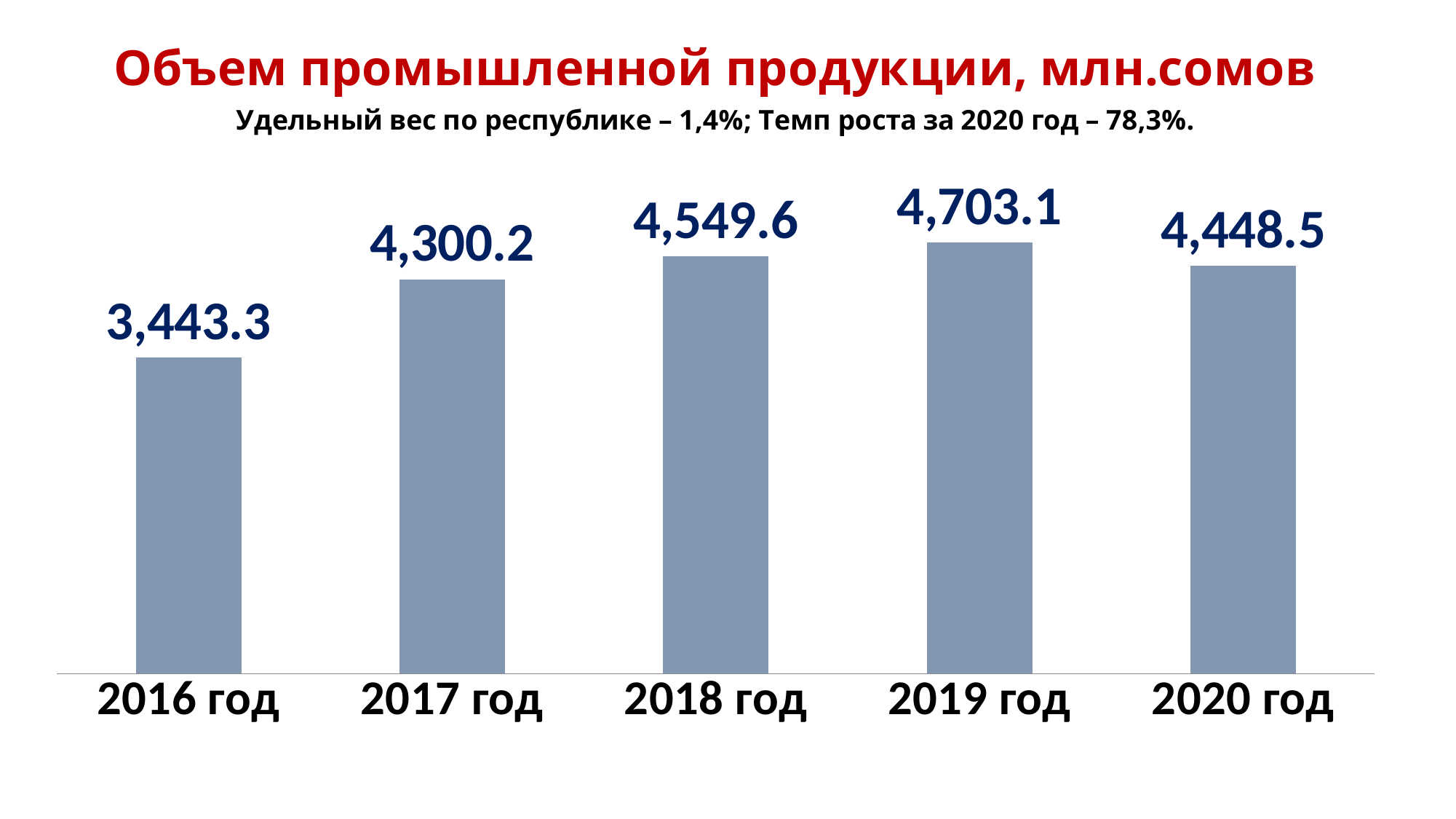
Do the values rise or fall from 2016 год to 2019 год? Rise By how much did the value fall from 2019 год to 2020 год? 254.6 What is the title of the chart? Объем промышленной продукции, млн.сомов What kind of chart is shown on the slide? Bar chart What is the value for 2019 год? 4,703.1 What is the value for 2020 год? 4,448.5 Which year has the lowest value? 2016 год How many years are shown on the chart? 5 Which year has the highest value? 2019 год What is the value for 2016 год? 3,443.3 Which is larger, the value for 2018 год or the value for 2020 год? 2018 год What is the difference between the values for 2019 год and 2016 год? 1,259.8